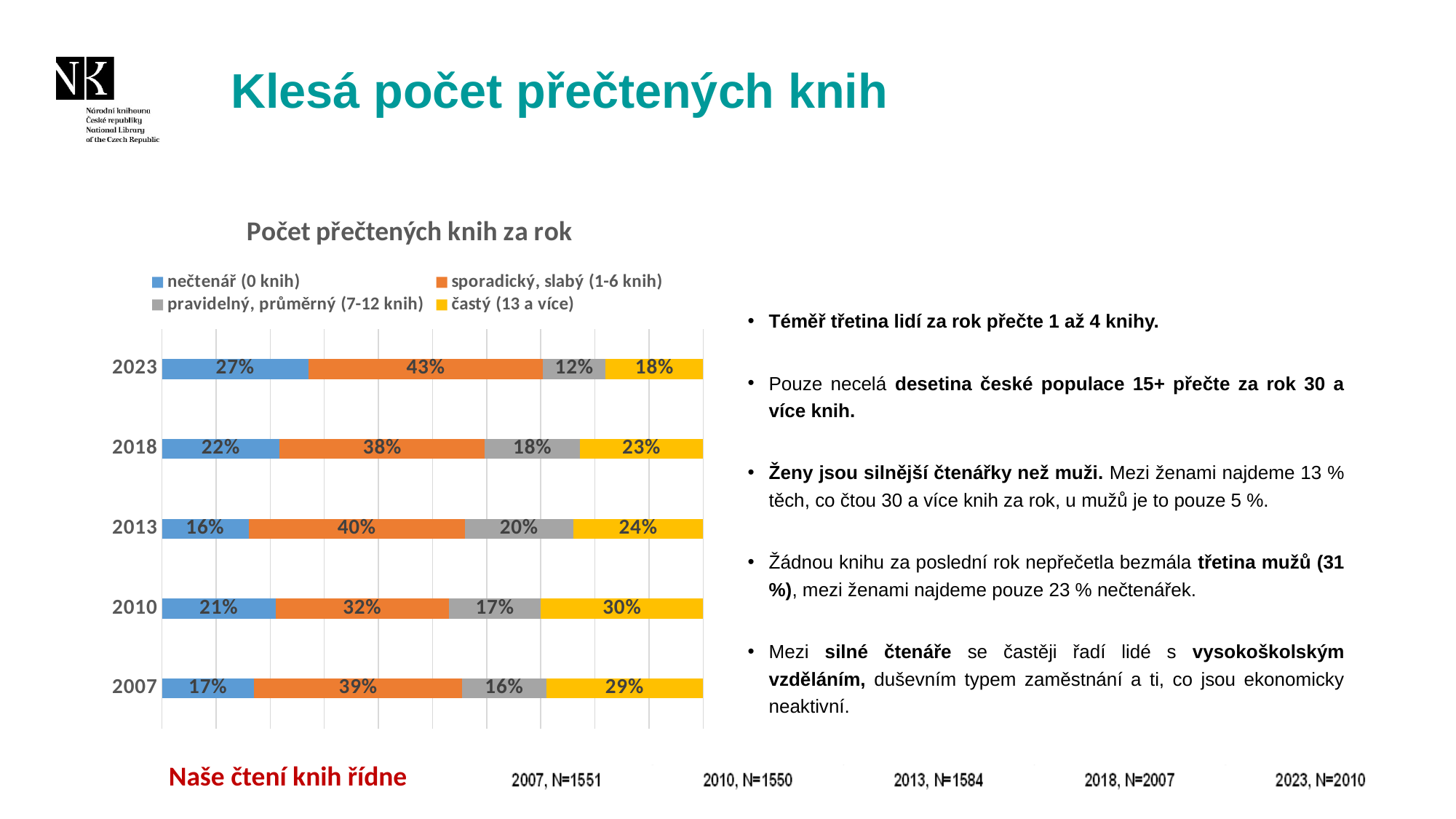
What is the share of pravidelný, průměrný (7-12 knih) in 2013? 20% In which year is the share of nečtenář (0 knih) the highest? 2023 What is the share of nečtenář (0 knih) in 2023? 27% Does the share of nečtenář (0 knih) rise or fall from 2013 to 2023? rise In which year is the share of častý (13 a více) the lowest? 2023 How many years (categories) are shown in the chart? 5 Which is larger: the share of častý (13 a více) in 2007 or in 2018? 2007 How many series does the chart legend list? 4 What is the share of častý (13 a více) in 2010? 30% What type of chart is shown on the slide? stacked bar chart What is the difference between the share of sporadický, slabý (1-6 knih) in 2023 and in 2018? 5% What is the title of the chart? Počet přečtených knih za rok